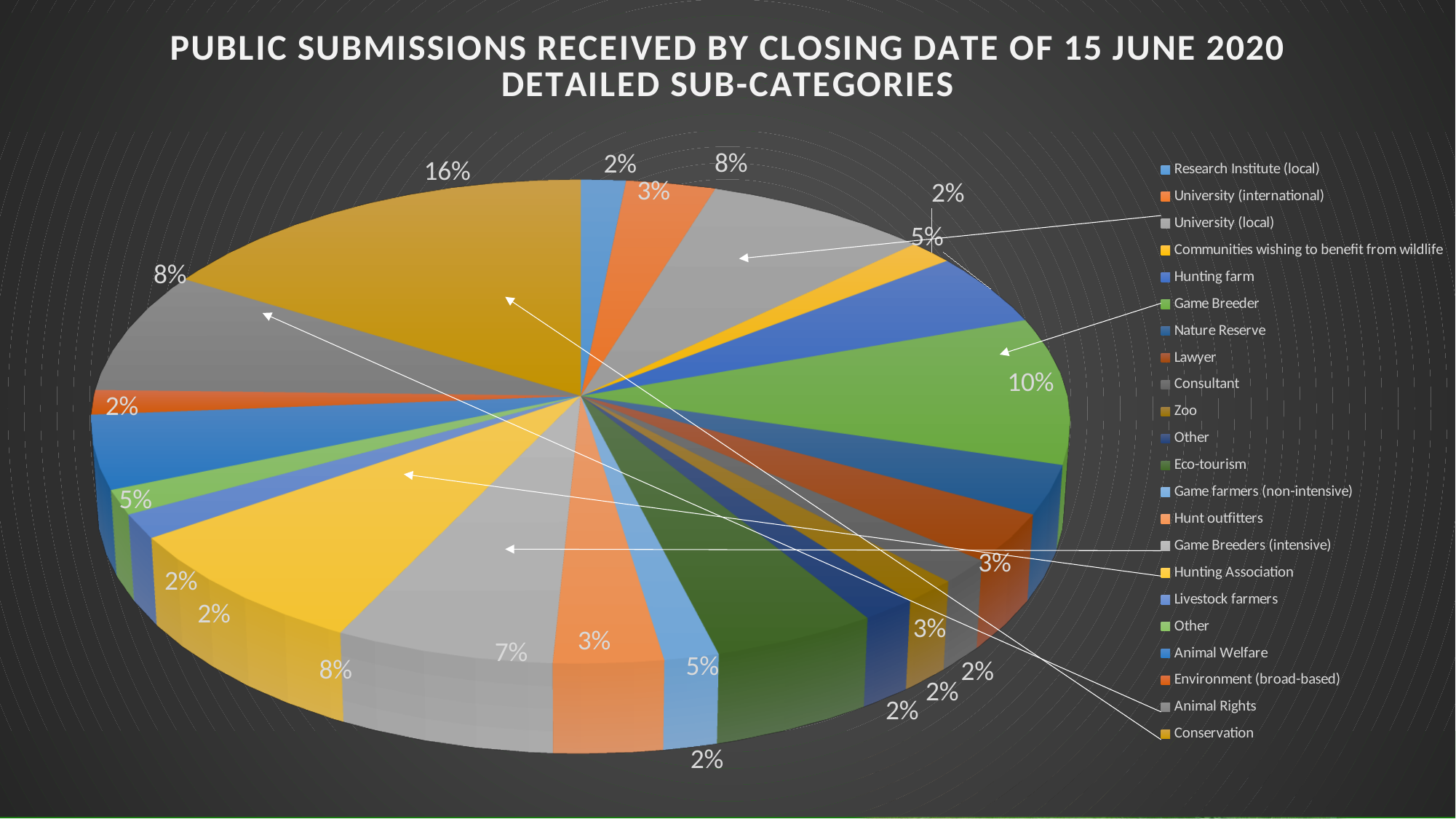
By how many percentage points does Conservation's share exceed Game Breeder's share? 6 percentage points What share of public submissions came from Animal Rights? 8% What share of public submissions came from Conservation? 16% What kind of chart is shown on the slide? Pie chart How many sub-categories does the legend list? 22 What share of public submissions came from Game Breeders (intensive)? 7% Which has the larger share, Conservation or Game Breeder? Conservation Which sub-category has the largest share of public submissions? Conservation What is the closing date mentioned in the chart title? 15 June 2020